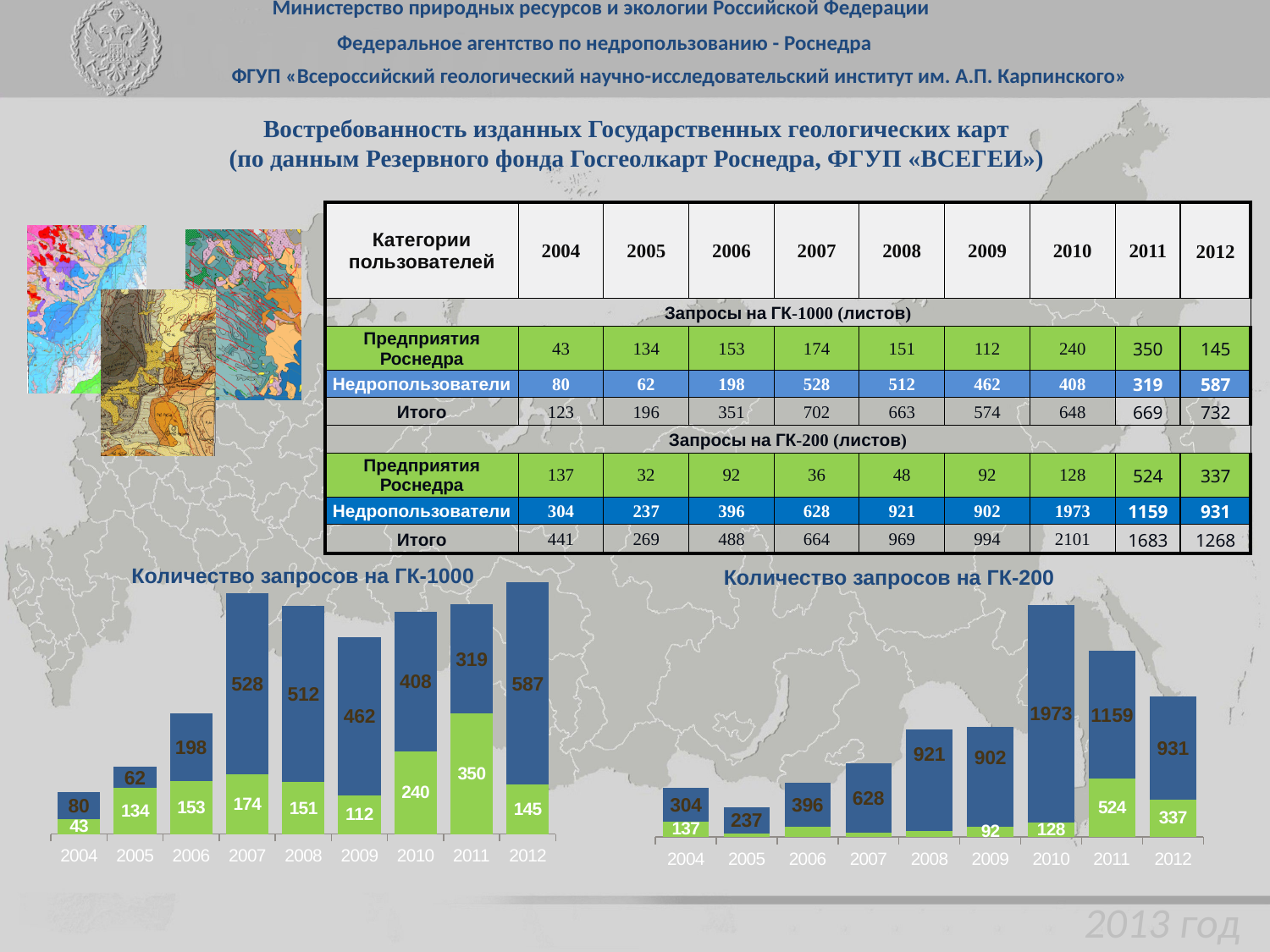
In the chart 'Количество запросов на ГК-1000', what is the difference between the blue and green segments for 2012? 442 What kind of chart is 'Количество запросов на ГК-200'? Stacked bar chart In the chart 'Количество запросов на ГК-1000', do the bar totals rise or fall from 2004 to 2007? Rise In the chart 'Количество запросов на ГК-200', is the blue segment larger in 2008 or in 2009? 2008 In the chart 'Количество запросов на ГК-1000', what is the total of the stacked bar for 2007? 702 In the chart 'Количество запросов на ГК-1000', what is the value of the blue segment for 2007? 528 How many years are shown on the x axis of the chart 'Количество запросов на ГК-1000'? 9 In the chart 'Количество запросов на ГК-200', which year has the tallest bar? 2010 In the chart 'Количество запросов на ГК-1000', which year has the shortest bar? 2004 In the chart 'Количество запросов на ГК-1000', what is the value of the green segment for 2011? 350 In the chart 'Количество запросов на ГК-200', what is the value of the blue segment for 2010? 1973 In the chart 'Количество запросов на ГК-200', what is the total of the stacked bar for 2011? 1683